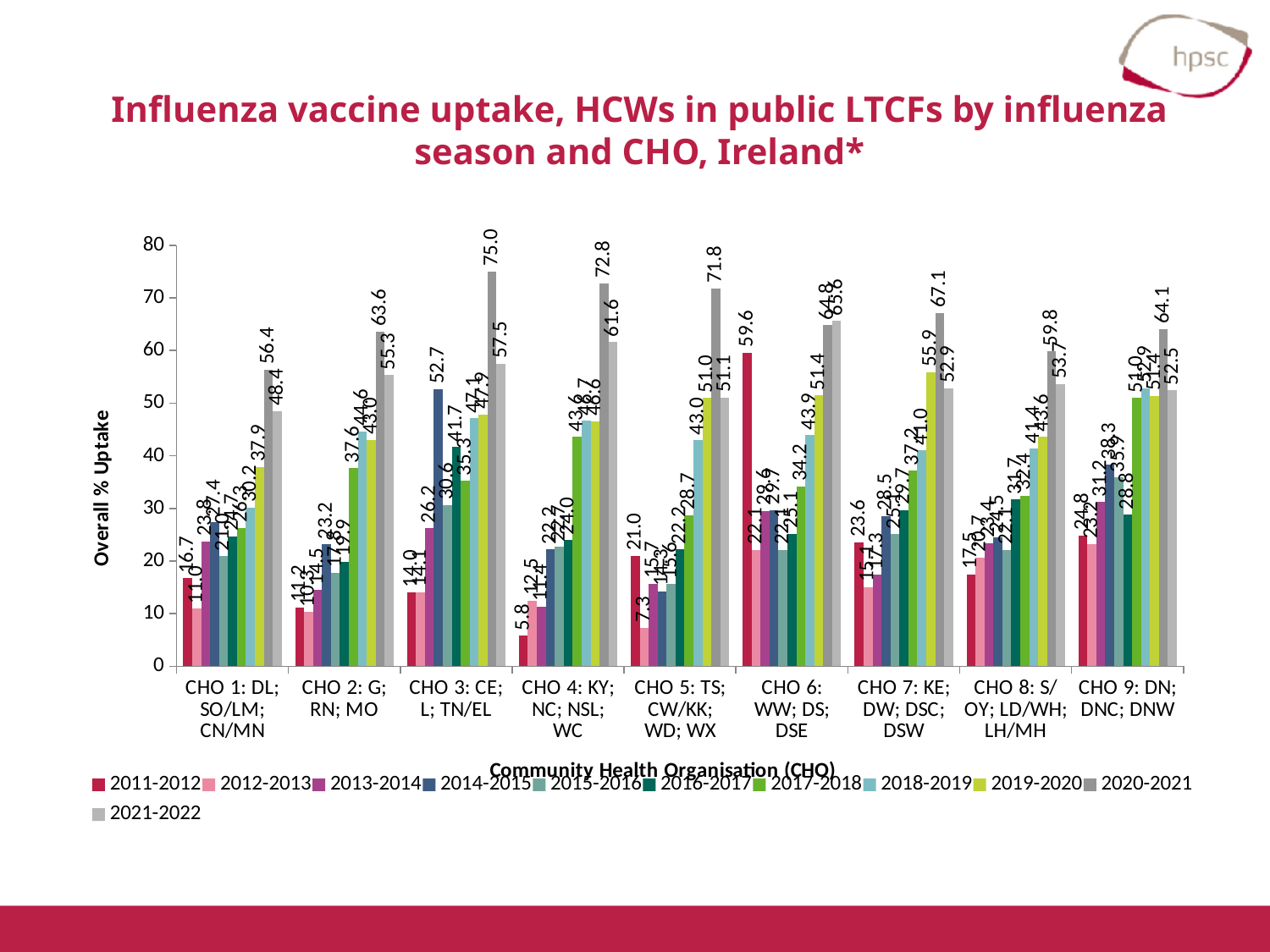
Is the 2020-2021 value for CHO 1: DL; SO/LM; CN/MN greater or less than 50? greater What was the overall % uptake for CHO 3: CE; L; TN/EL in the 2020-2021 season? 75.0 In the 2021-2022 season, which had the higher overall % uptake: CHO 6: WW; DS; DSE or CHO 4: KY; NC; NSL; WC? CHO 6: WW; DS; DSE What is the label on the y axis of the chart? Overall % Uptake For CHO 3: CE; L; TN/EL, how much higher was the overall % uptake in 2020-2021 than in 2021-2022? 17.5 What was the overall % uptake for CHO 6: WW; DS; DSE in the 2011-2012 season? 59.6 How many influenza seasons does the legend list? 11 Which CHO had the highest overall % uptake in the 2020-2021 season? CHO 3: CE; L; TN/EL What kind of chart is shown on the slide? Bar chart Which CHO had the lowest overall % uptake in the 2011-2012 season? CHO 4: KY; NC; NSL; WC How many Community Health Organisations (CHOs) are shown on the x axis? 9 What was the overall % uptake for CHO 4: KY; NC; NSL; WC in the 2020-2021 season? 72.8